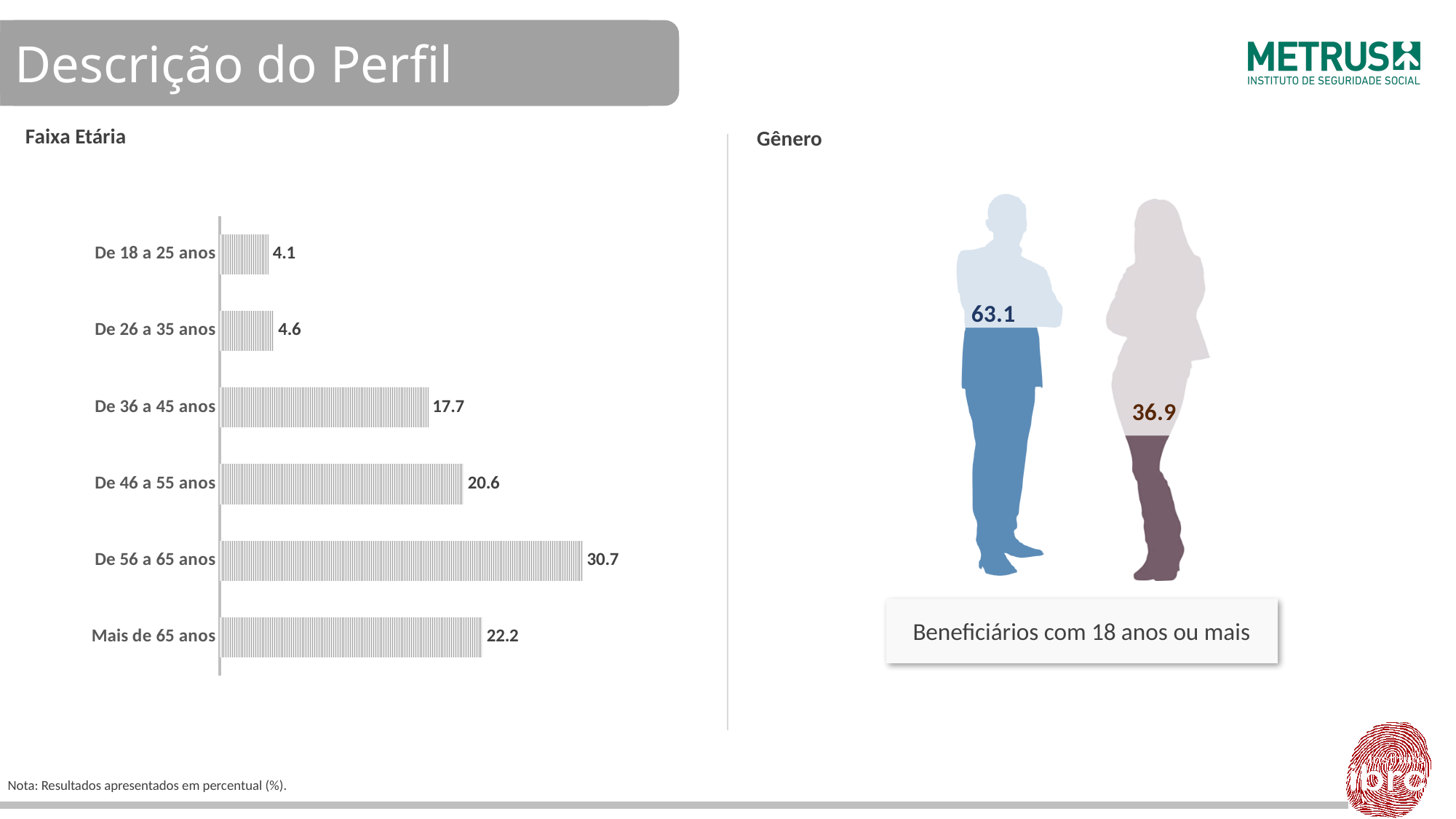
In the Faixa Etária chart, which age group has the highest value? De 56 a 65 anos In the Faixa Etária chart, what is the value for De 36 a 45 anos? 17.7 In the Faixa Etária chart, what is the value for De 56 a 65 anos? 30.7 In the Faixa Etária chart, which age group has the lowest value? De 18 a 25 anos In the Gênero graphic, what is the value shown for the female figure? 36.9 What kind of chart is the Faixa Etária chart? Bar chart In the Faixa Etária chart, what is the value for Mais de 65 anos? 22.2 In the Gênero graphic, what is the difference between the male and female values? 26.2 In the Gênero graphic, what is the value shown for the male figure? 63.1 How many age groups are shown in the Faixa Etária chart? 6 In the Faixa Etária chart, what is the difference between De 56 a 65 anos and De 46 a 55 anos? 10.1 In the Faixa Etária chart, which is larger: De 46 a 55 anos or Mais de 65 anos? Mais de 65 anos